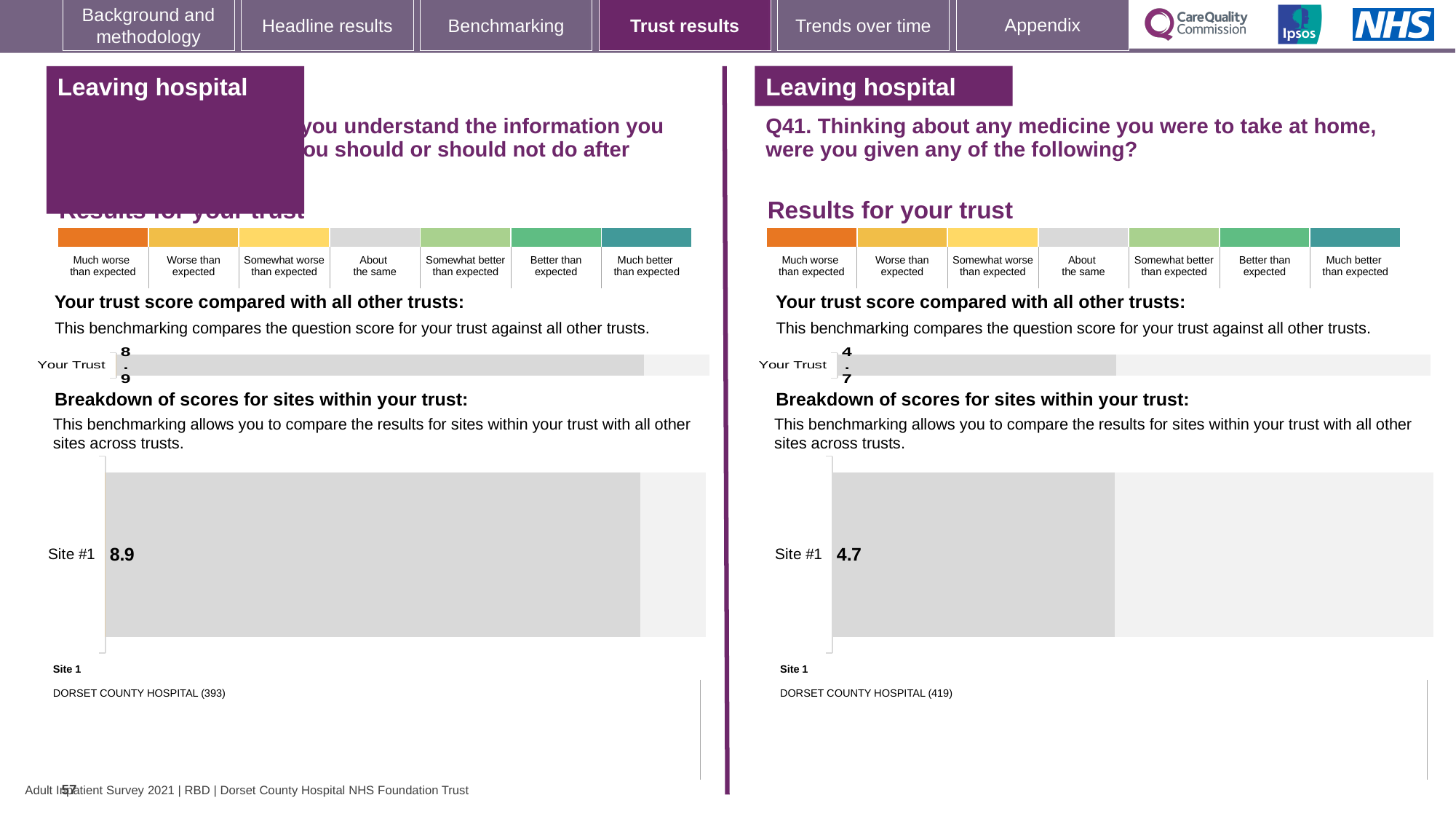
How many sites are shown on the left-hand 'Breakdown of scores for sites within your trust' chart? 1 What is the difference between the Site #1 score on the left-hand breakdown chart and the Site #1 score on the right-hand breakdown chart (Q41)? 4.2 What kind of chart is used for the 'Breakdown of scores for sites within your trust' on the right-hand side (Q41)? Bar chart On the right-hand 'Breakdown of scores for sites within your trust' chart (Q41), what is the score for Site #1? 4.7 On the left-hand 'Breakdown of scores for sites within your trust' chart, what is the score for Site #1? 8.9 How many sites are shown on the right-hand 'Breakdown of scores for sites within your trust' chart (Q41)? 1 On the right-hand side (Q41), which hospital is listed as Site 1 below the breakdown chart? DORSET COUNTY HOSPITAL (419) Which Site #1 score is larger: the one on the left-hand breakdown chart or the one on the right-hand breakdown chart (Q41)? Left-hand chart (8.9) On the right-hand 'Your trust score compared with all other trusts' chart (Q41), what is the value shown for Your Trust? 4.7 On the left-hand side, what number appears in parentheses after DORSET COUNTY HOSPITAL in the Site 1 label? 393 On the left-hand side, is the Site #1 score the same as the Your Trust score? Yes, both are 8.9 On the left-hand 'Your trust score compared with all other trusts' chart, what is the value shown for Your Trust? 8.9